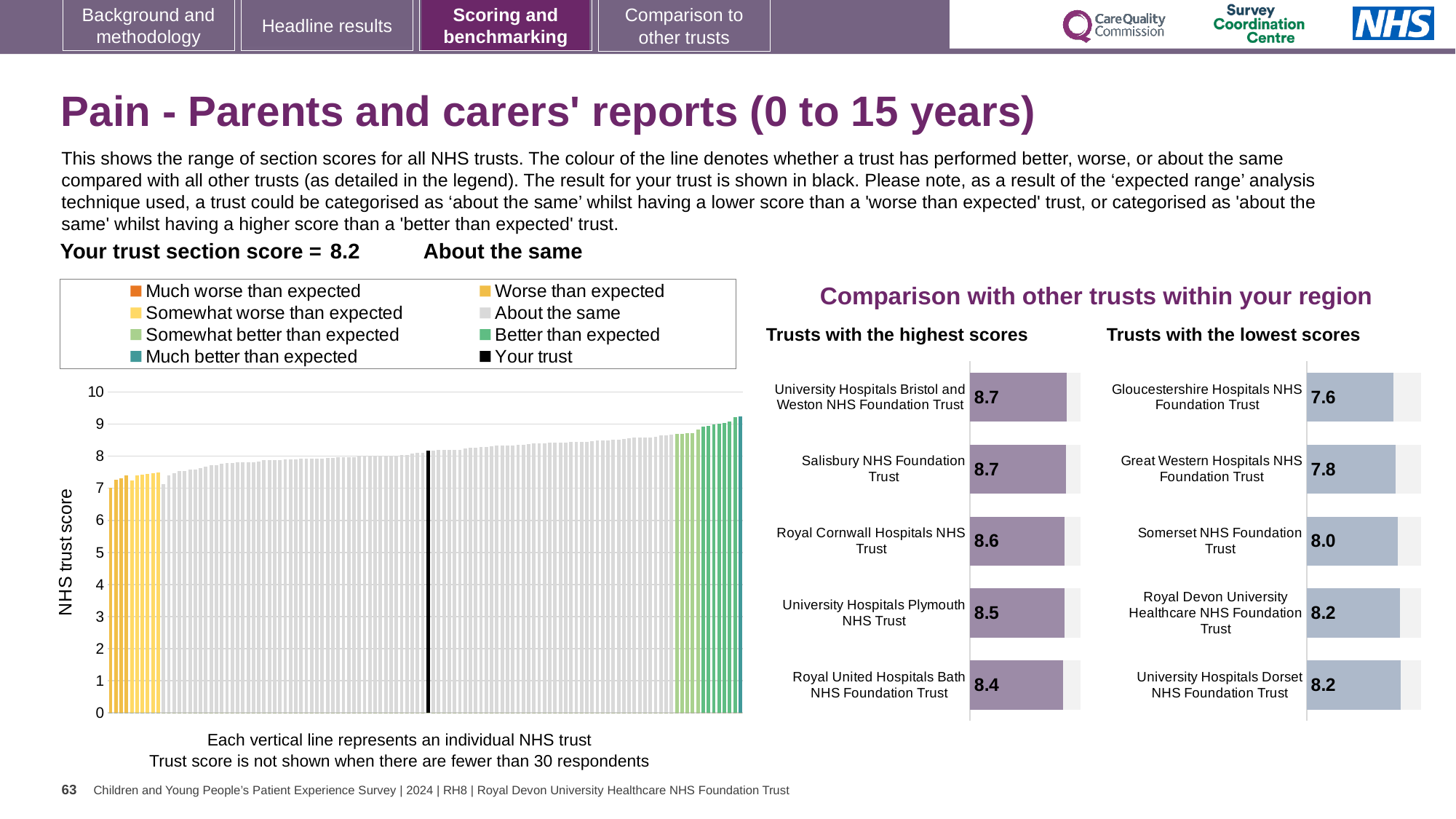
In the 'Trusts with the lowest scores' chart, which has the higher score: Somerset NHS Foundation Trust or Great Western Hospitals NHS Foundation Trust? Somerset NHS Foundation Trust How many entries does the legend above the left-hand chart list? 8 How many trusts are listed in the 'Trusts with the highest scores' chart? 5 How many trusts are listed in the 'Trusts with the lowest scores' chart? 5 In the 'Trusts with the highest scores' chart, what is the difference between the score for University Hospitals Bristol and Weston NHS Foundation Trust and the score for Royal United Hospitals Bath NHS Foundation Trust? 0.3 In the 'Trusts with the highest scores' chart, what is the score for Royal Cornwall Hospitals NHS Trust? 8.6 In the 'Trusts with the lowest scores' chart, what is the difference between the score for Royal Devon University Healthcare NHS Foundation Trust and the score for Gloucestershire Hospitals NHS Foundation Trust? 0.6 What kind of chart is the large chart on the left showing NHS trust scores? bar chart In the 'Trusts with the lowest scores' chart, what is the score for Gloucestershire Hospitals NHS Foundation Trust? 7.6 What is the y-axis label of the large chart on the left? NHS trust score In the 'Trusts with the lowest scores' chart, which trust has the lowest score? Gloucestershire Hospitals NHS Foundation Trust In the 'Trusts with the highest scores' chart, which trust has the lowest score shown? Royal United Hospitals Bath NHS Foundation Trust